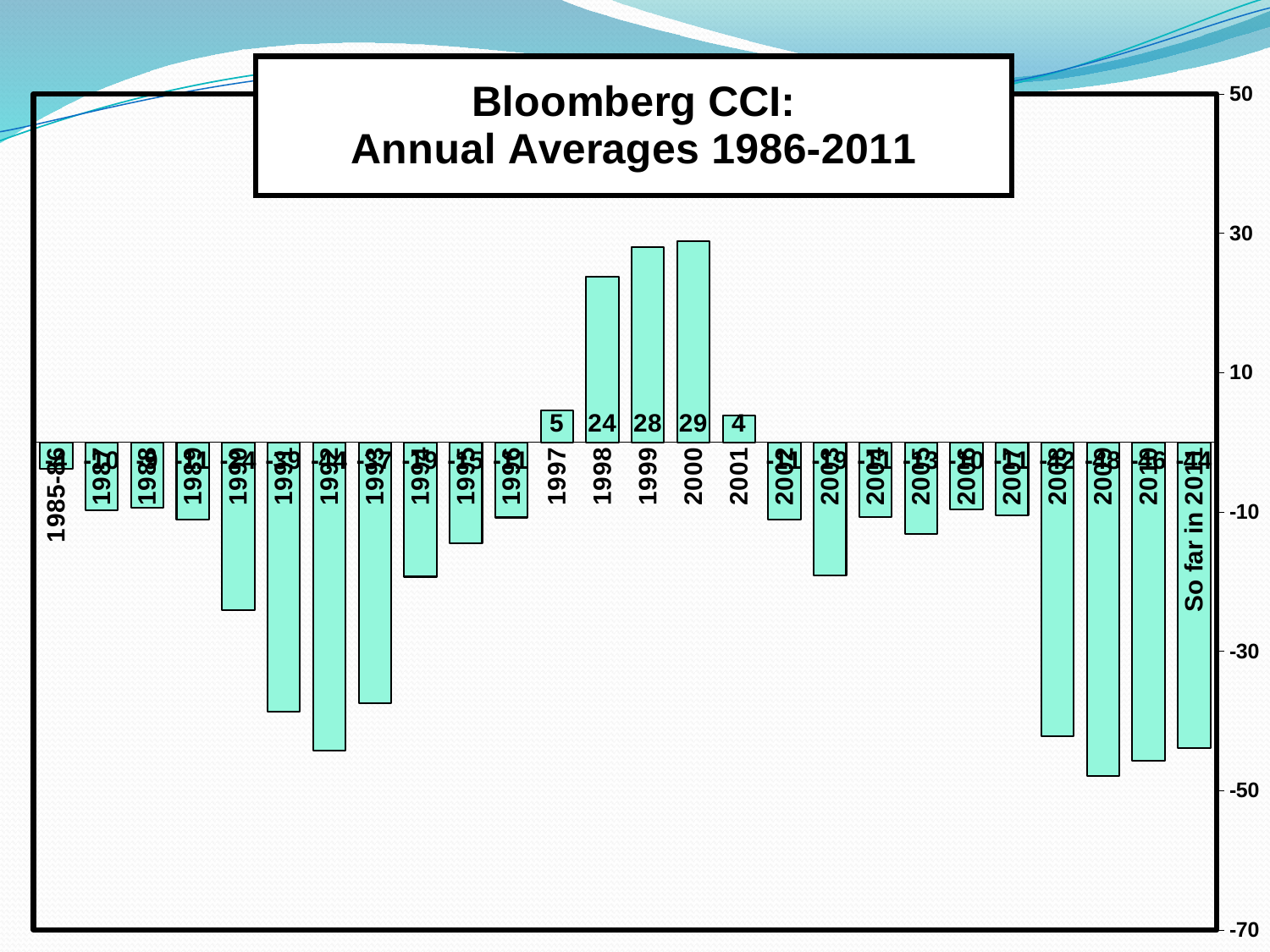
How many categories are shown on the x axis? 26 Which is larger, the value for 1999 or the value for 1997? 1999 What is the difference between the values for 2000 and 1998? 5 What is the value for 1998? 24 Is the value for 1992 greater or less than -30? less What is the value for 2000? 29 Which year has the lowest value? 2009 What is the value for 2001? 4 What kind of chart is this? bar chart Is the value for 2003 greater or less than -30? greater What is the title of the chart? Bloomberg CCI: Annual Averages 1986-2011 Which year has the highest value? 2000